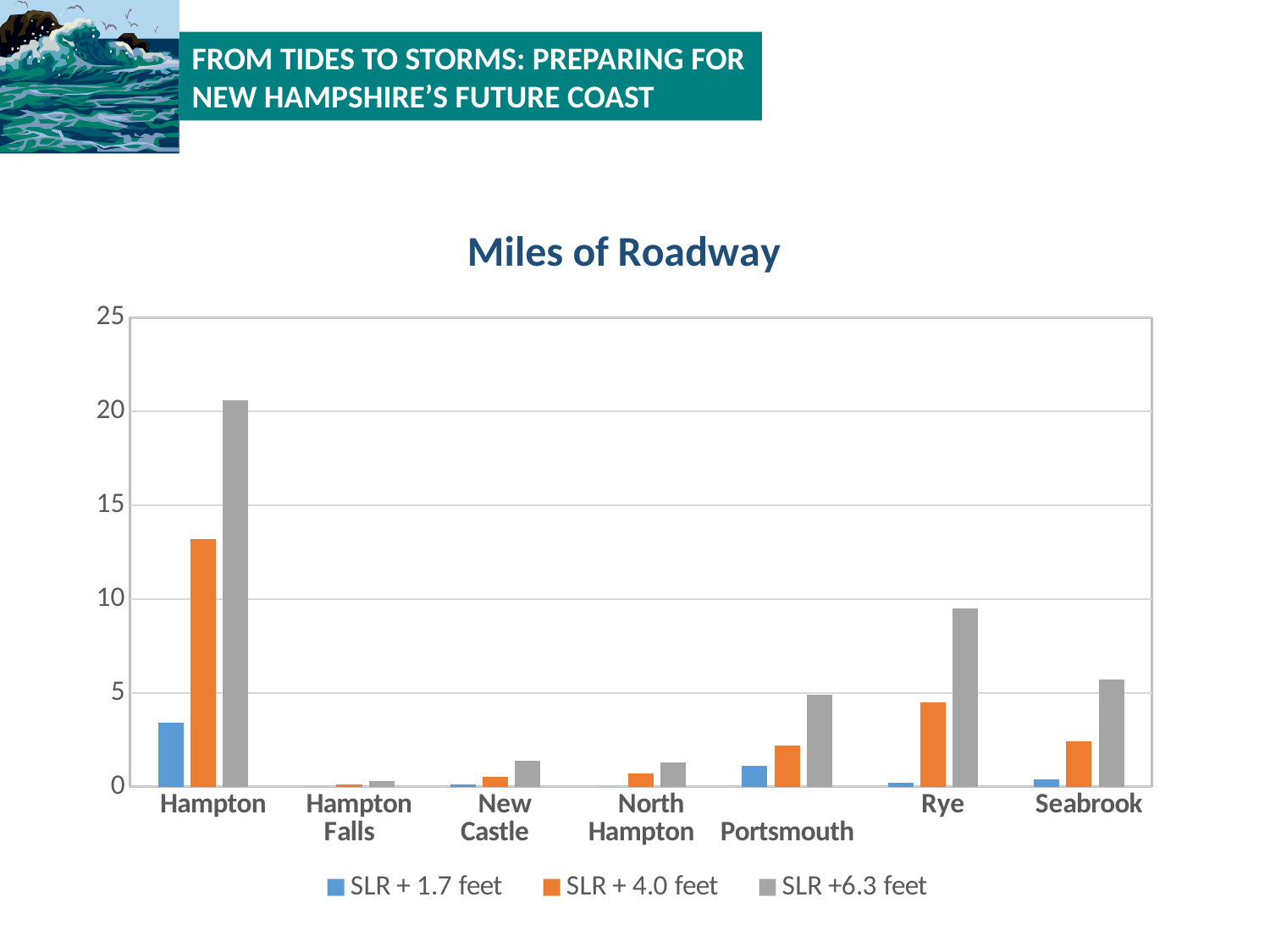
Which town has the highest value for SLR +6.3 feet? Hampton How many series does the legend list? 3 What kind of chart is shown on the slide? bar chart Is the value for Rye under SLR +6.3 feet greater or less than 10? less Is the value for Hampton under SLR +6.3 feet greater or less than 20? greater How many towns are shown on the x axis? 7 What is the title of the chart? Miles of Roadway Is the value for Hampton under SLR + 4.0 feet greater or less than 10? greater Which is larger: the SLR + 4.0 feet value for Portsmouth or for Rye? Rye Which series is shown in gray in the legend? SLR +6.3 feet Which town has the highest value for SLR + 4.0 feet? Hampton Which is larger: the SLR +6.3 feet value for Rye or for Seabrook? Rye